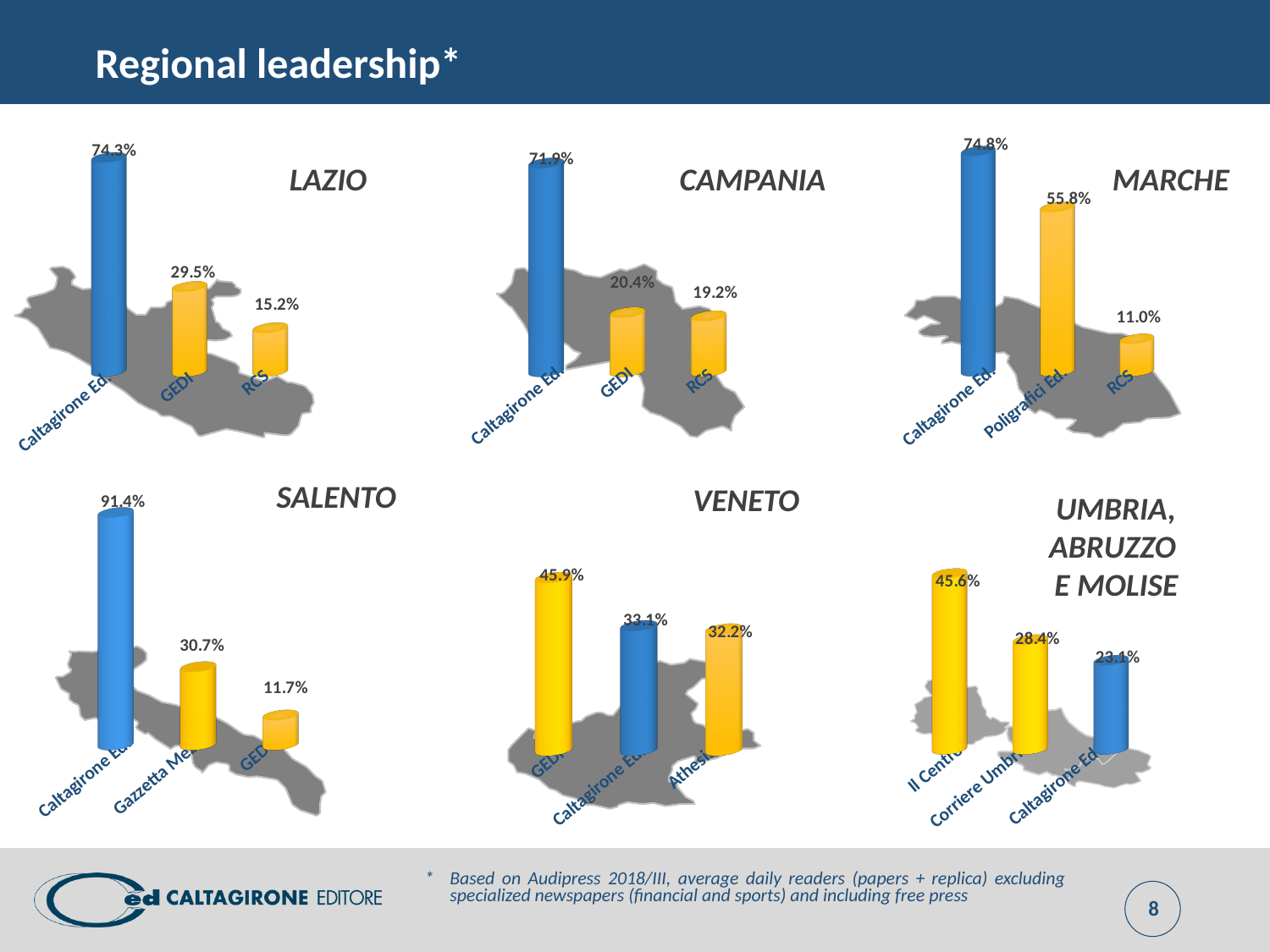
In the MARCHE chart, what is the value for Poligrafici Ed.? 55.8% In the VENETO chart, what is the value for Caltagirone Ed.? 33.1% In the CAMPANIA chart, what is the difference between the values for Caltagirone Ed. and GEDI? 51.5% In the VENETO chart, which category has the highest value? GEDI In the LAZIO chart, what is the value for GEDI? 29.5% In the CAMPANIA chart, what is the value for RCS? 19.2% In the SALENTO chart, what is the value for Caltagirone Ed.? 91.4% In the UMBRIA, ABRUZZO E MOLISE chart, what is the value for Il Centro? 45.6% In the SALENTO chart, what is the value for GEDI? 11.7% In the LAZIO chart, what is the value for Caltagirone Ed.? 74.3% How many charts are shown on the slide? 6 In the MARCHE chart, which category has the lowest value? RCS